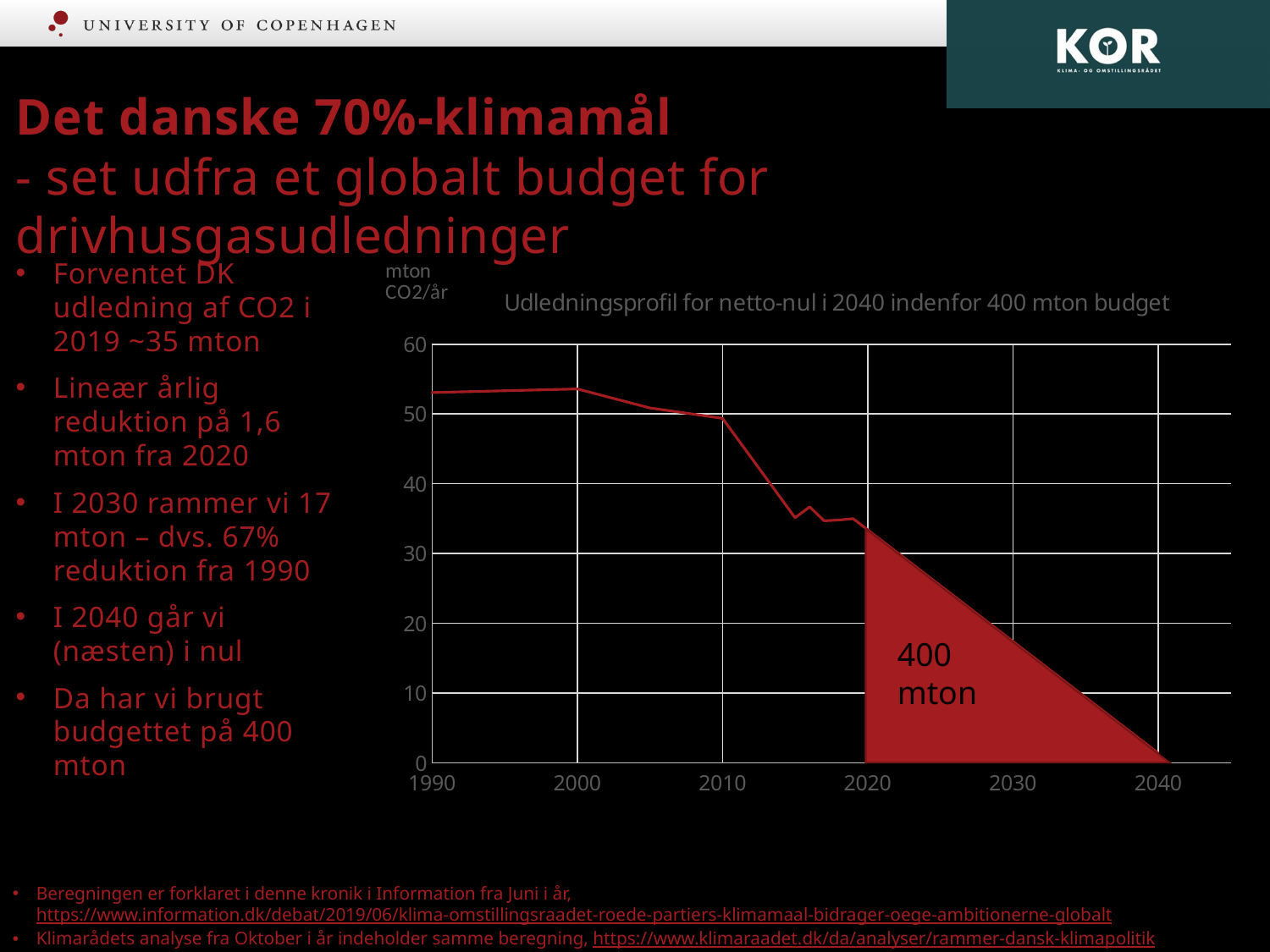
Which year has the larger value, 1990 or 2020? 1990 Do the plotted values rise or fall from 1990 to 2040? fall How many year labels are shown on the x axis? 6 Is the value for 2030 greater or less than 20? less What is the title of the chart? Udledningsprofil for netto-nul i 2040 indenfor 400 mton budget What kind of chart is shown on the slide? line chart Is the value for 2020 greater or less than 40? less Is the value for 1990 greater or less than 50? greater What unit is shown on the vertical axis of the chart? mton CO2/år Which year on the x axis has the lowest value? 2040